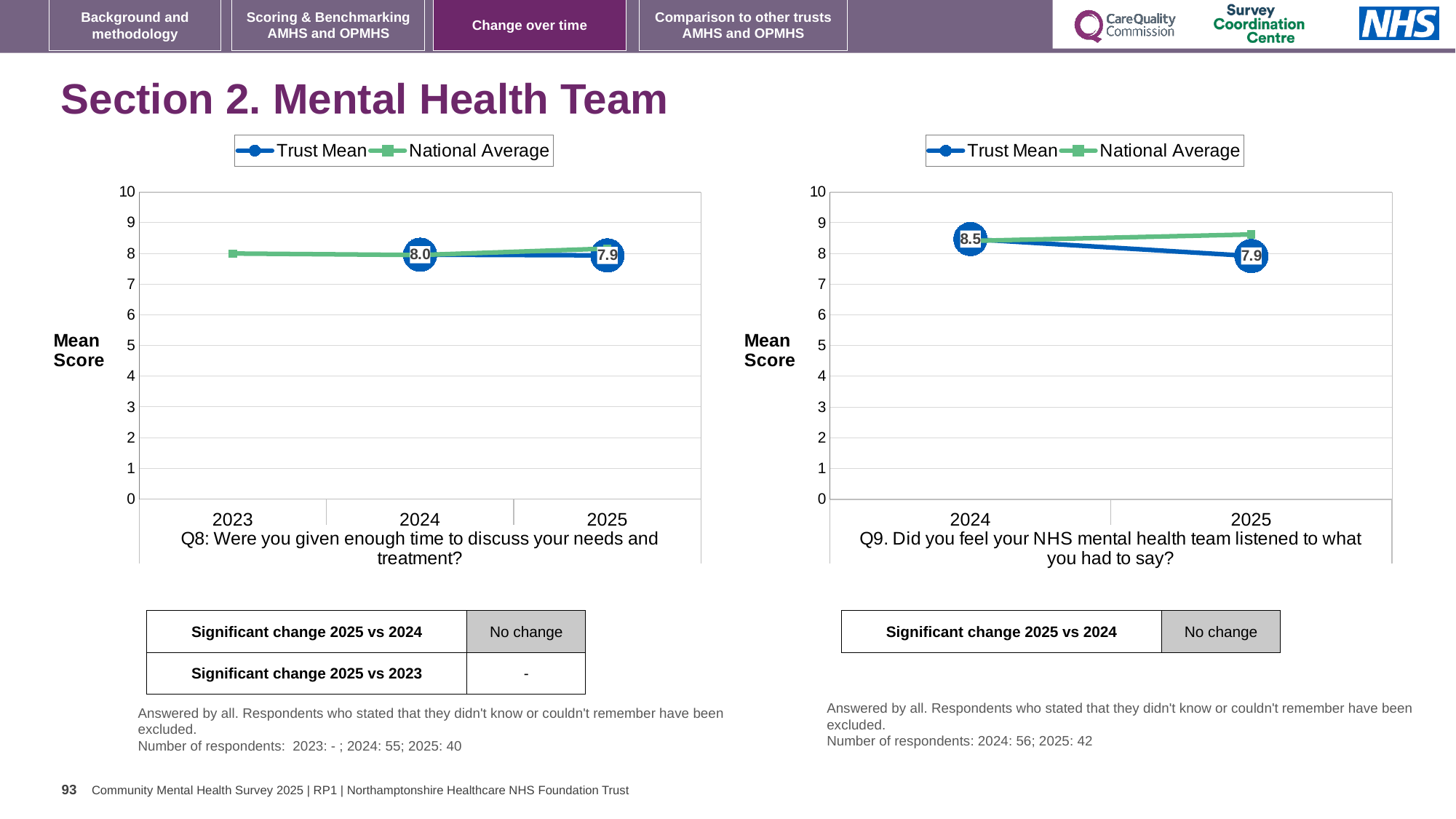
In the Q8 chart (left), is the National Average for 2023 greater or less than 5? greater In the Q9 chart (right), is the Trust Mean for 2025 higher or lower than the National Average for 2025? lower In the Q9 chart (right), which year has the higher Trust Mean? 2024 In the Q8 chart (left), what is the Trust Mean for 2024? 8.0 In the Q9 chart (right), does the Trust Mean rise or fall from 2024 to 2025? fall In the Q9 chart (right), what is the Trust Mean for 2024? 8.5 In the Q9 chart (right), what is the Trust Mean for 2025? 7.9 How many years are shown on the x axis of the Q8 chart (left)? 3 In the Q8 chart (left), what is the difference between the Trust Mean for 2024 and 2025? 0.1 What type of chart is the Q9 chart (right)? line chart In the Q9 chart (right), what is the difference between the Trust Mean for 2024 and 2025? 0.6 In the Q8 chart (left), what is the Trust Mean for 2025? 7.9